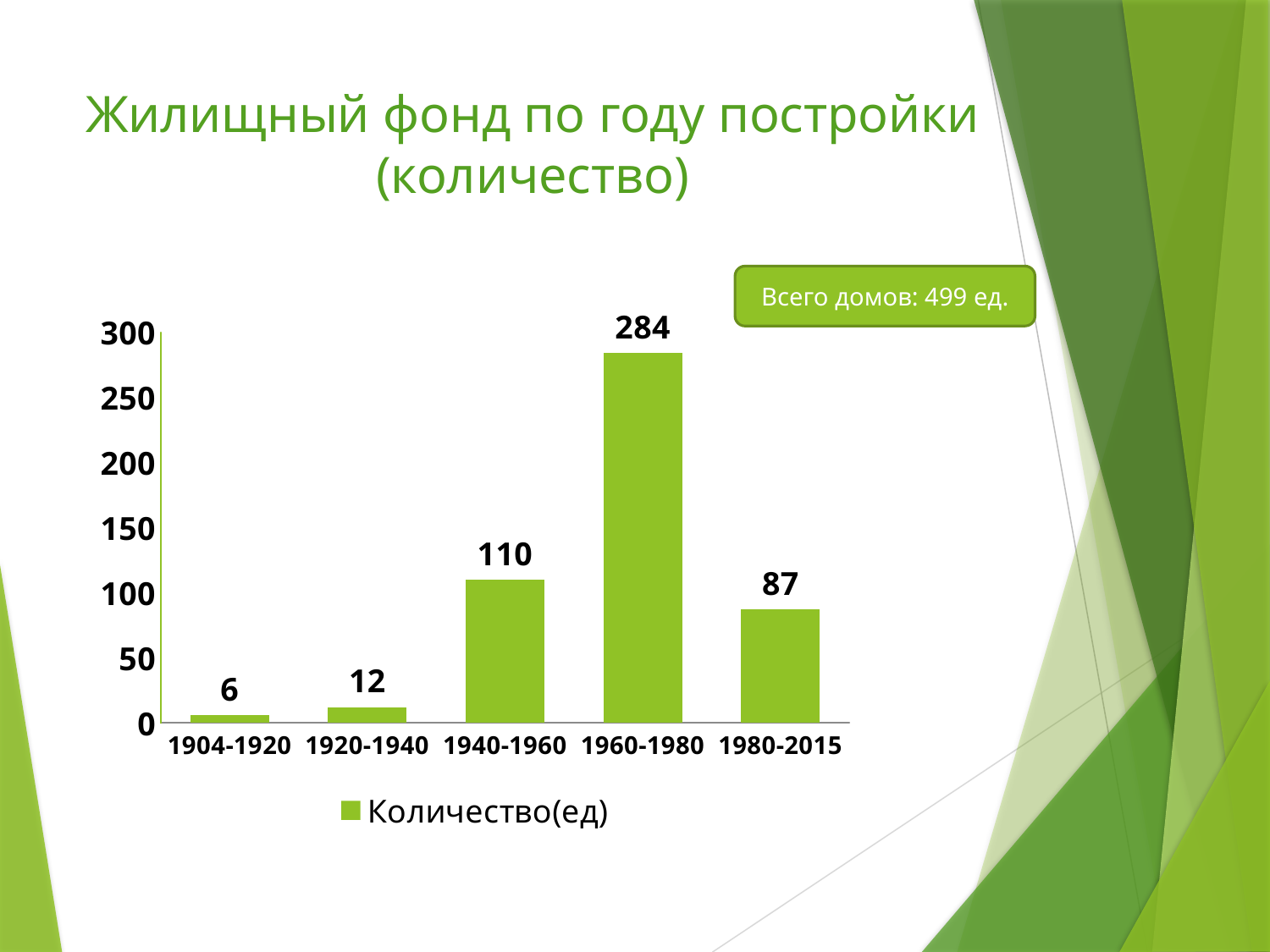
What is the value for 1960-1980? 284 What is the difference between the values for 1960-1980 and 1940-1960? 174 What is the difference between the values for 1920-1940 and 1904-1920? 6 Which period has the lowest value? 1904-1920 What series name does the legend show? Количество(ед) Is the value for 1960-1980 greater or less than 250? greater What is the value for 1904-1920? 6 How many periods are shown on the x axis? 5 Which period has the highest value? 1960-1980 What kind of chart is shown on the slide? bar chart What is the value for 1980-2015? 87 Which is larger, the value for 1940-1960 or the value for 1980-2015? 1940-1960